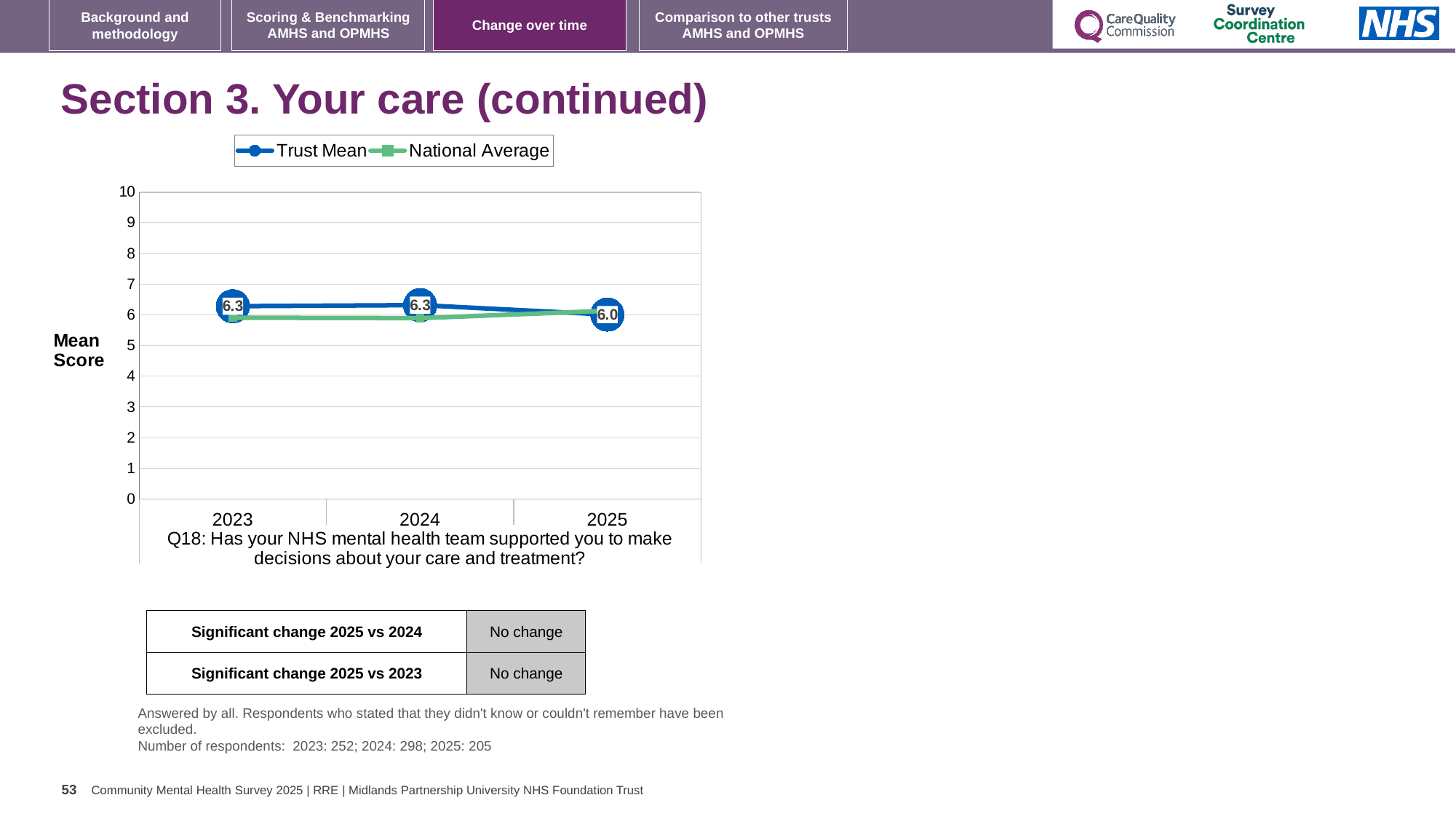
Does the Trust Mean rise or fall from 2024 to 2025? fall Is the National Average value for 2023 greater or less than 7? less What is the Trust Mean value for 2023? 6.3 Which is larger, the Trust Mean for 2024 or the Trust Mean for 2025? 2024 What is the difference between the Trust Mean in 2023 and in 2025? 0.3 What is the Trust Mean value for 2024? 6.3 In which year is the Trust Mean lowest? 2025 What kind of chart is shown on the slide? line chart What is the Trust Mean value for 2025? 6.0 How many series does the legend list? 2 Is the National Average value for 2025 greater or less than 5? greater How many years are plotted on the x axis? 3